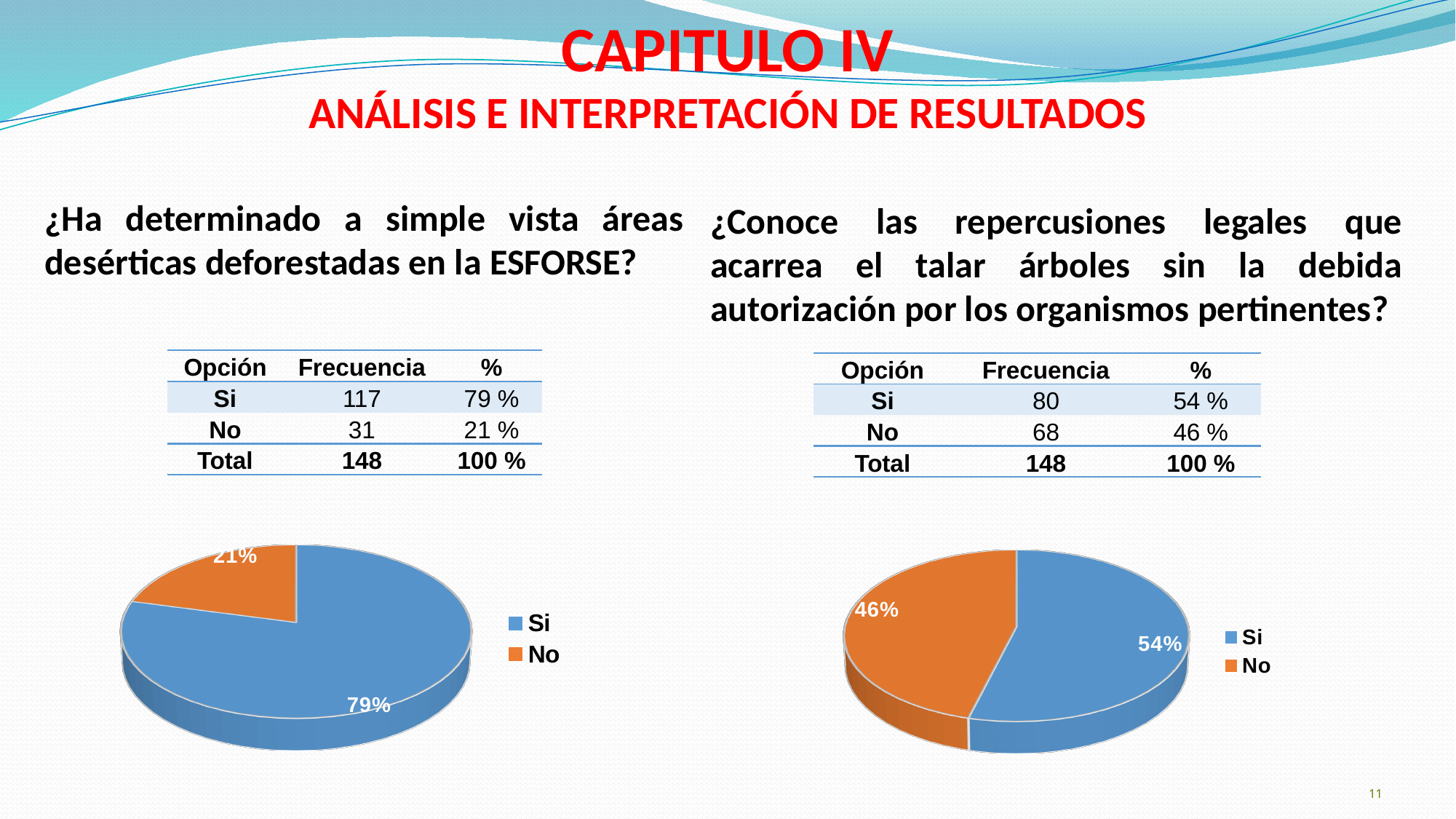
In the right pie chart, which is larger, the Si slice or the No slice? Si In the left pie chart, which slice is the largest? Si In the right pie chart, which slice is the smallest? No In the right pie chart, what share is labelled for No? 46% In the left pie chart, what share is labelled for Si? 79% In the right pie chart, what is the difference in percentage points between the Si and No slices? 8 In the right pie chart, what share is labelled for Si? 54% How many slices does the right pie chart have? 2 In the left pie chart, what share is labelled for No? 21% In the left pie chart, what colour is the No slice? Orange In the left pie chart, what is the difference in percentage points between the Si and No slices? 58 What type of chart is shown on the left of the slide? Pie chart